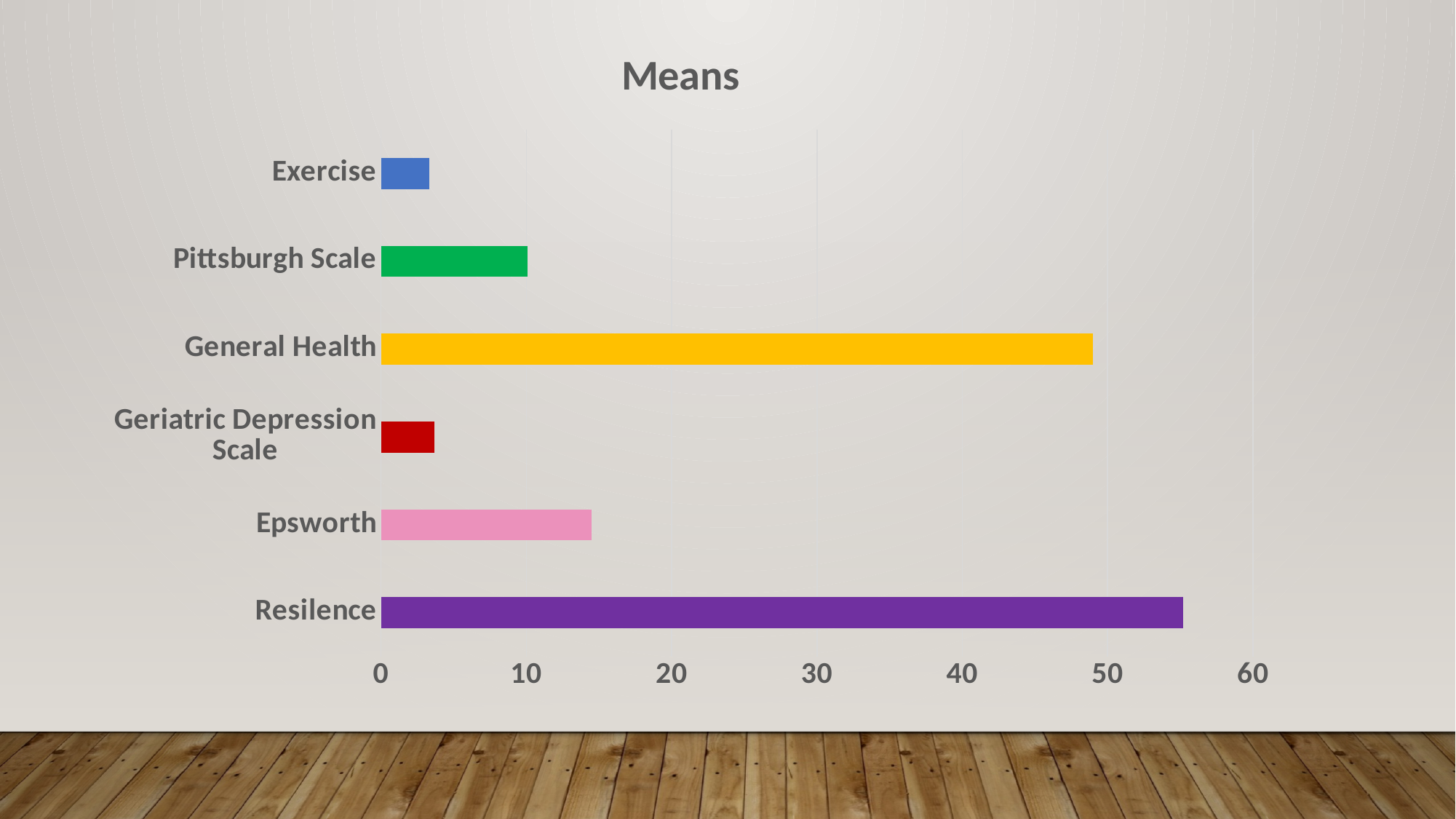
Which is larger, the value for General Health or the value for Epsworth? General Health Which is larger, the value for Resilence or the value for General Health? Resilence How many categories are plotted in the chart? 6 Is the value for General Health greater or less than 40? greater Which is larger, the value for Epsworth or the value for Pittsburgh Scale? Epsworth What colour is the bar for Resilence? purple What kind of chart is shown on the slide? bar chart Which category has the highest value? Resilence Is the value for Resilence greater or less than 50? greater Is the value for Exercise greater or less than 10? less What is the title of the chart? Means